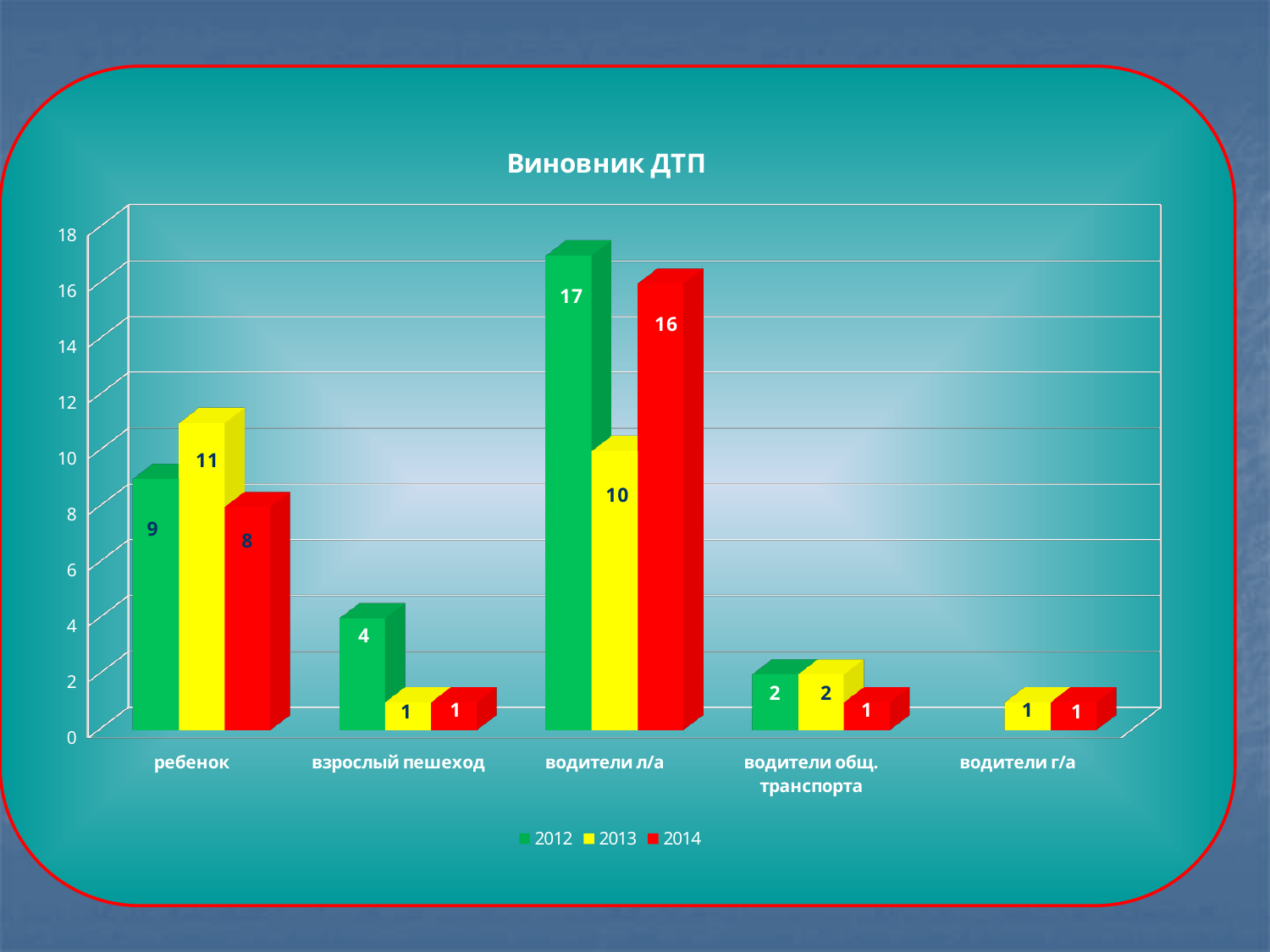
Which category has the highest value in the 2014 series? водители л/а How many series does the legend list? 3 What is the difference between the 2012 and 2013 values for водители л/а? 7 What kind of chart is shown on the slide? bar chart What is the title of the chart? Виновник ДТП How many categories are shown on the x axis? 5 Which colour represents the 2013 series in the legend? yellow Which category has the lowest value in the 2012 series among those with a labelled bar? водители общ. транспорта What is the value for водители л/а in the 2012 series? 17 Which is larger for ребенок: the 2012 value or the 2014 value? 2012 What is the value for взрослый пешеход in the 2014 series? 1 What is the value for ребенок in the 2013 series? 11